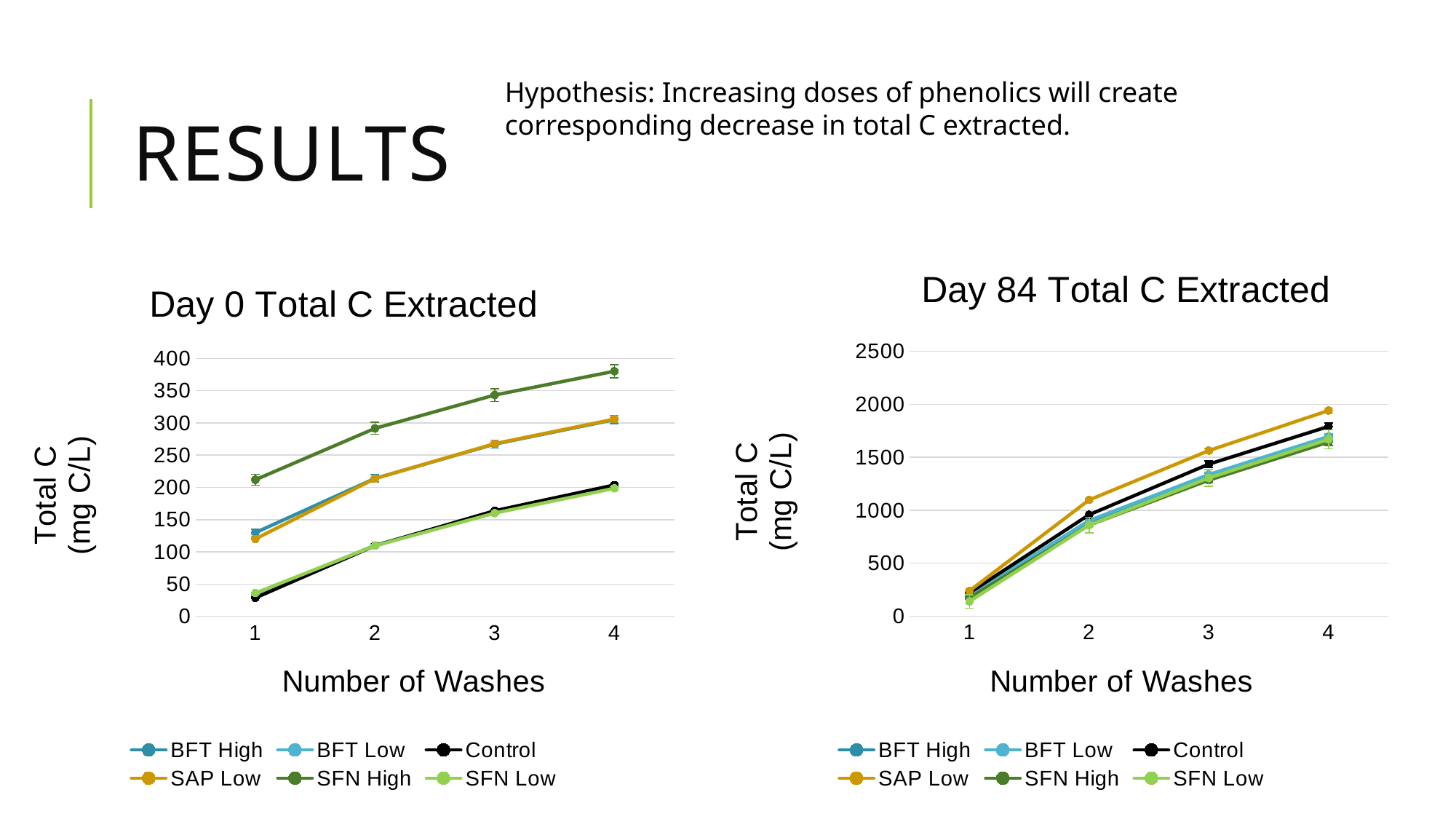
In the "Day 84 Total C Extracted" chart, is the value for Control at 1 wash greater or less than 500? less In the "Day 0 Total C Extracted" chart, is the value for Control at 1 wash greater or less than 50? less In the "Day 0 Total C Extracted" chart, which is larger at 4 washes: SFN High or Control? SFN High What is the y-axis label of the "Day 84 Total C Extracted" chart? Total C (mg C/L) In the "Day 84 Total C Extracted" chart, which series has the highest value at 4 washes? SAP Low In the "Day 84 Total C Extracted" chart, is the value for SAP Low at 4 washes greater or less than 1500? greater How many series does the legend of the "Day 84 Total C Extracted" chart list? 6 What kind of chart is the "Day 0 Total C Extracted" chart? line chart In the "Day 0 Total C Extracted" chart, which series has the highest value at 4 washes? SFN High How many wash numbers are plotted on the x axis of the "Day 0 Total C Extracted" chart? 4 In the "Day 0 Total C Extracted" chart, do the values for SFN High rise or fall as the number of washes increases? rise